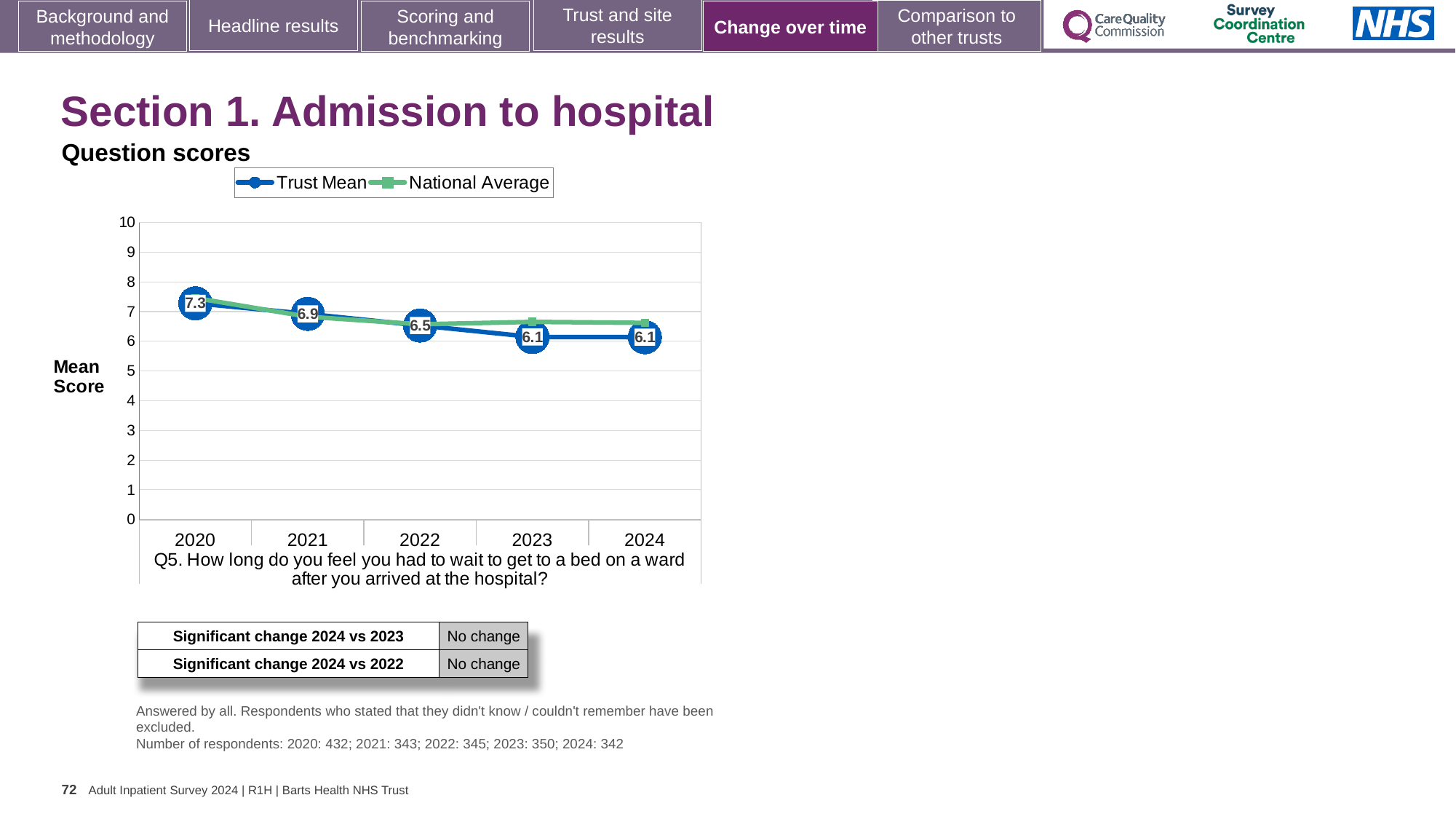
What kind of chart is shown on the slide? line chart What is the Trust Mean score for 2020? 7.3 Is the National Average value for 2023 greater or less than 6? greater What is the Trust Mean score for 2024? 6.1 Does the Trust Mean score rise or fall from 2020 to 2024? fall In 2023, which is higher: the Trust Mean or the National Average? National Average How many series does the chart legend list? 2 How many years are shown on the x axis of the chart? 5 What is the difference between the Trust Mean score in 2020 and in 2024? 1.2 What is the Trust Mean score for 2022? 6.5 In which year is the Trust Mean score highest? 2020 What is the difference between the Trust Mean score in 2021 and in 2022? 0.4